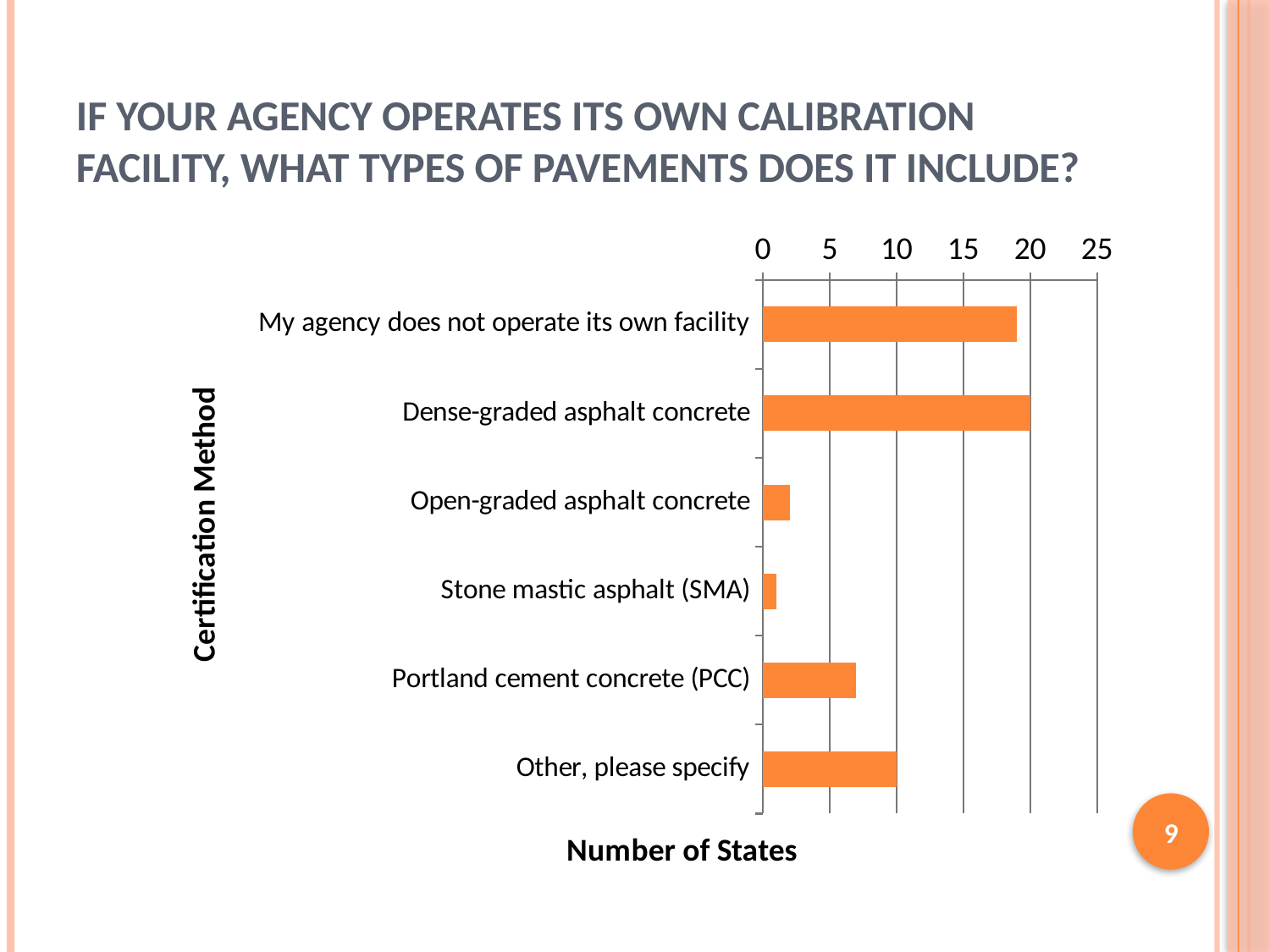
What is the number of states for Other, please specify? 10 How many categories are shown on the chart? 6 Is the value for My agency does not operate its own facility greater or less than 15? greater What is the title of the horizontal axis of the chart? Number of States Which has more states, Open-graded asphalt concrete or Portland cement concrete (PCC)? Portland cement concrete (PCC) Which has more states, Portland cement concrete (PCC) or Other, please specify? Other, please specify Which category has the lowest number of states? Stone mastic asphalt (SMA) What is the number of states for Dense-graded asphalt concrete? 20 Is the value for Open-graded asphalt concrete greater or less than 5? less What kind of chart is shown on the slide? bar chart Is the value for Portland cement concrete (PCC) greater or less than 10? less